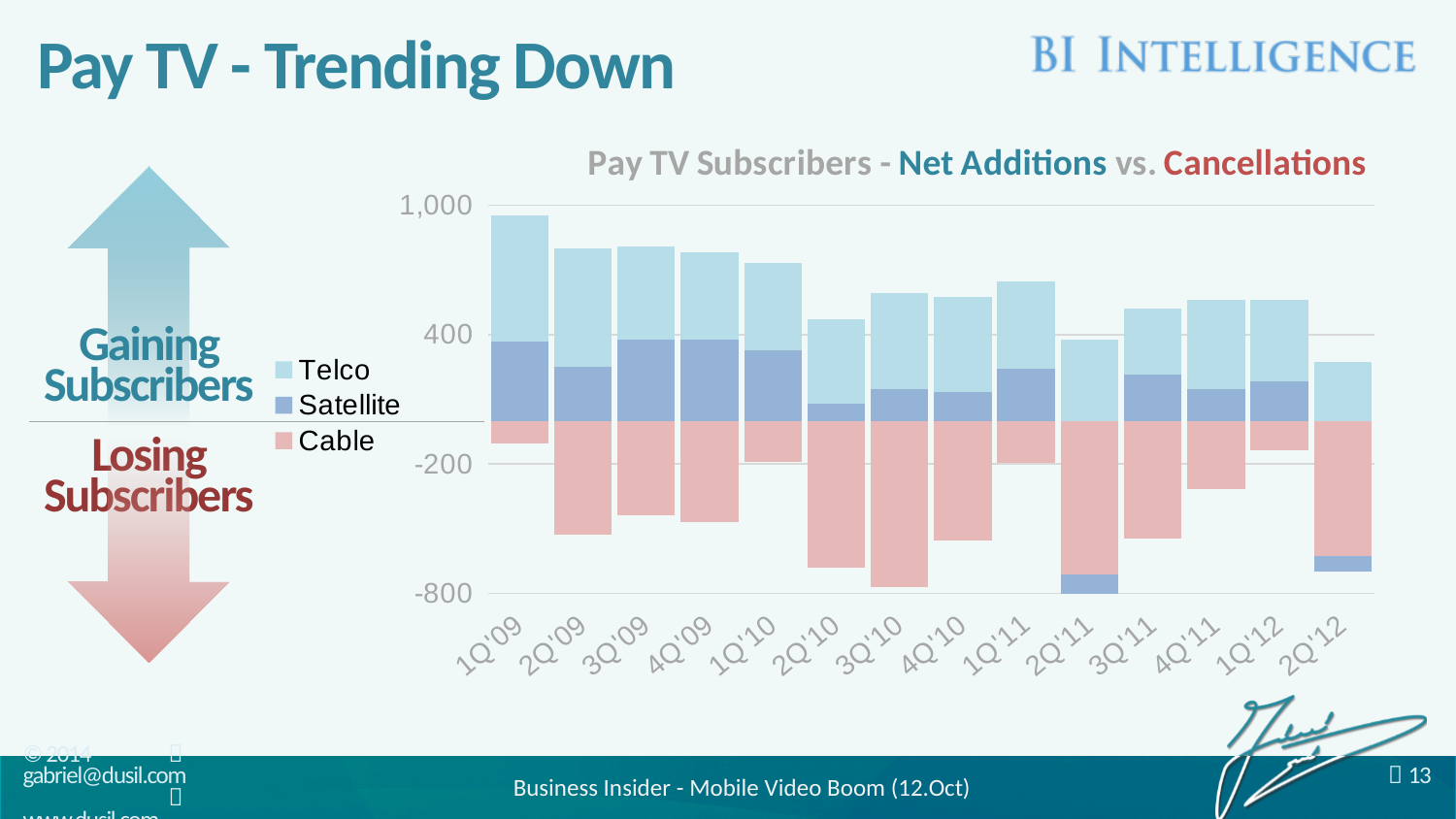
Which series are listed in the chart's legend? Telco, Satellite, Cable How many quarters are shown along the x axis of the chart? 14 Is the top of the positive stack for 2Q'12 greater or less than 400? less Which series is negative (cancellations) in every quarter shown? Cable What kind of chart is shown on the slide? Stacked bar chart How many series does the chart's legend list? 3 Which quarter has the tallest positive (net additions) stack in the chart? 1Q'09 Is the bottom of the Cable bar for 2Q'11 greater or less than -200? less What is the title of the chart? Pay TV Subscribers - Net Additions vs. Cancellations Do the positive net additions generally rise or fall from 1Q'09 to 2Q'12? fall Is the bottom of the Cable bar for 1Q'09 greater or less than -200? greater